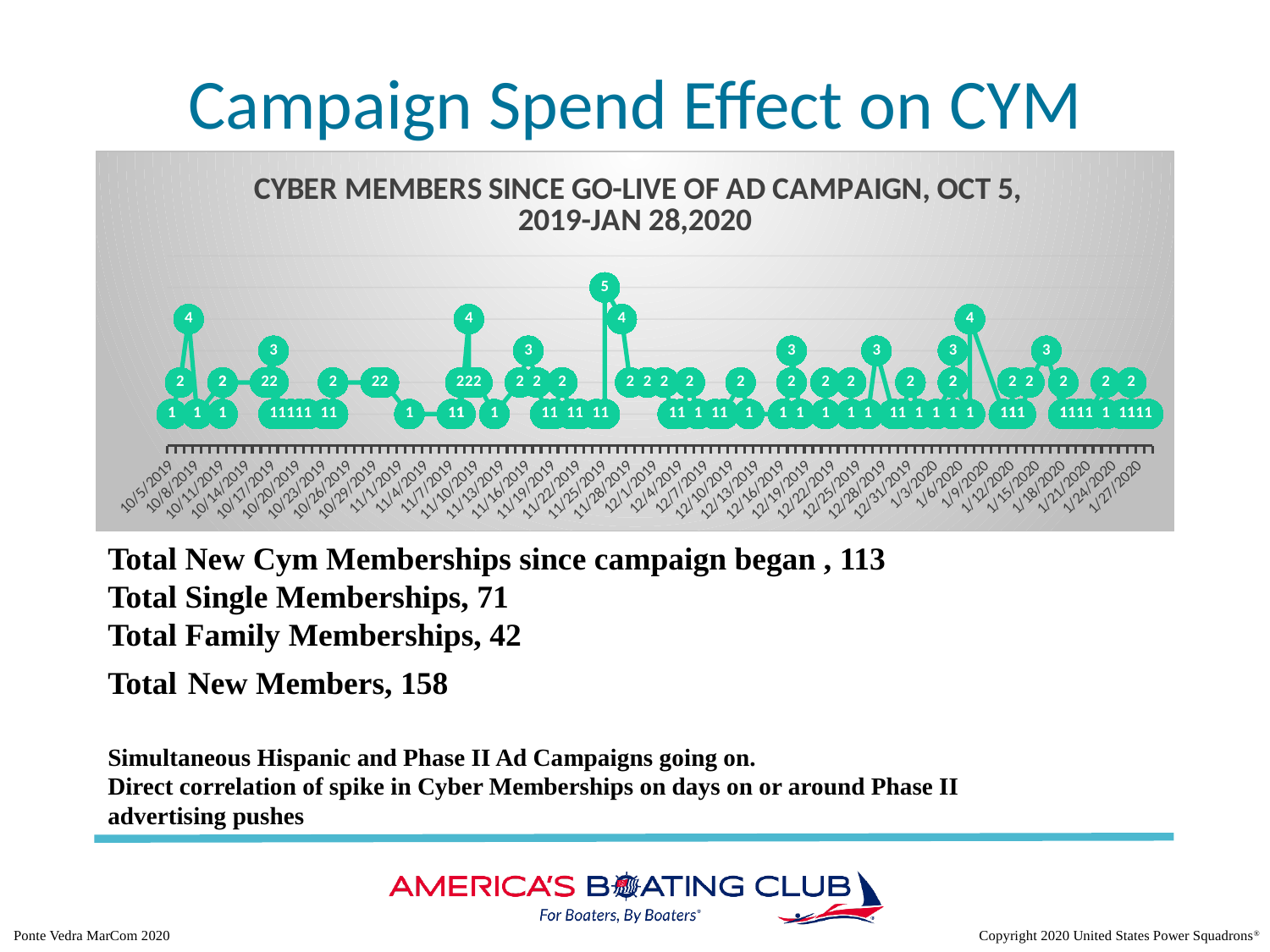
What colour are the data point markers on the line? Green Does the line show a steady rise over the period, or does it fluctuate? It fluctuates What kind of chart is shown on the slide? Line chart What is the highest daily value plotted on the chart? 5 What is the lowest daily value plotted on the chart? 1 What is the last date label on the x axis? 1/27/2020 What is the title of the chart? Cyber Members Since Go-Live of Ad Campaign, Oct 5, 2019-Jan 28,2020 What is the difference between the highest and lowest plotted values? 4 What is the first date label on the x axis? 10/5/2019 How many times does the plotted value reach 4? 4 How many times does the plotted value reach 5? 1